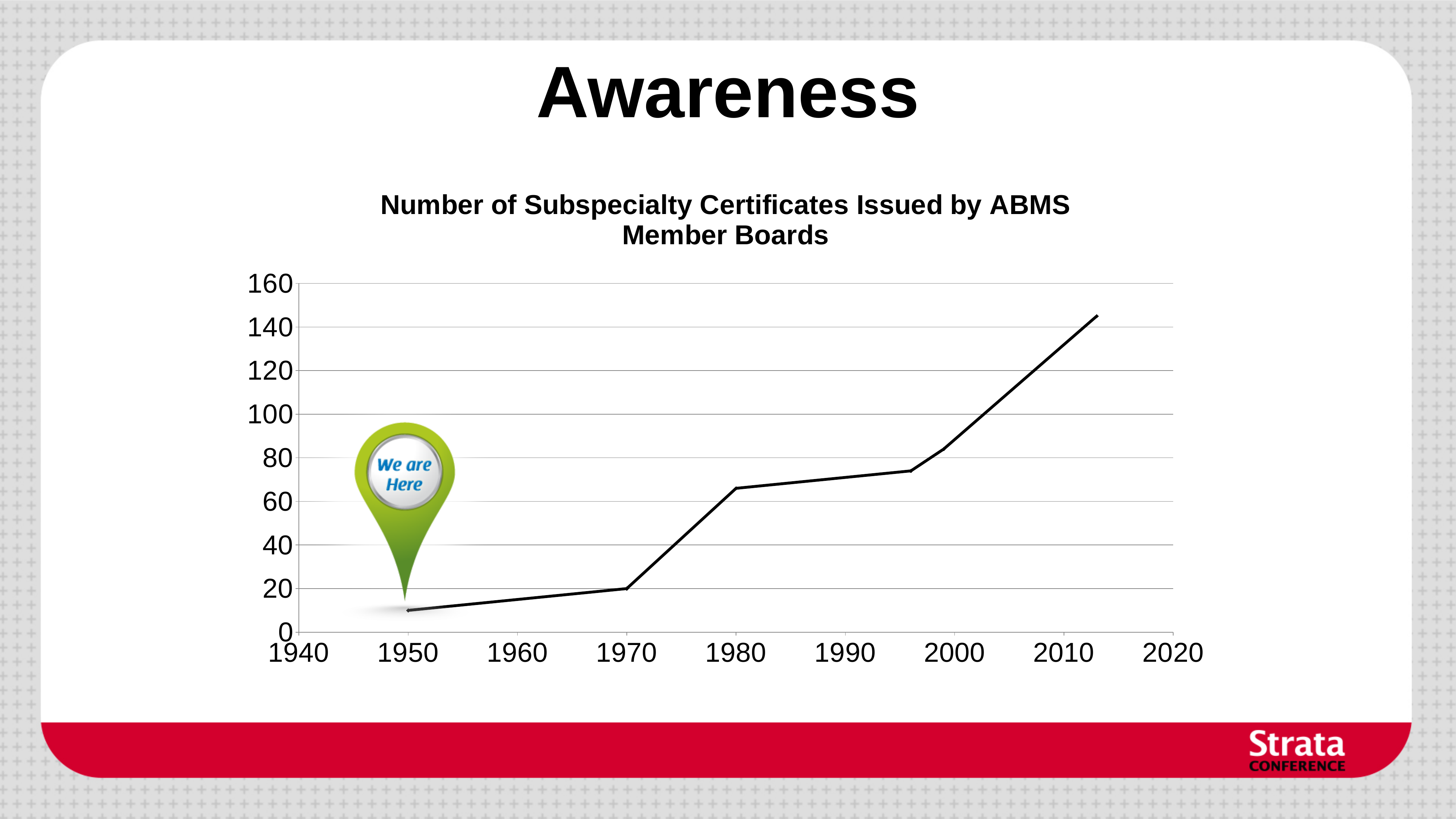
At which year does the line reach its lowest value? 1950 What is the title of the chart? Number of Subspecialty Certificates Issued by ABMS Member Boards Is the value for 1950 greater or less than 20? less What kind of chart is shown on the slide? line chart What is the highest value shown on the vertical axis? 160 Is the value for 1980 greater or less than 60? greater Is the value at the final point of the line greater or less than 140? greater Do the values in the chart generally rise or fall from 1950 to the end of the line? rise Which is larger, the value for 1970 or the value for 1980? 1980